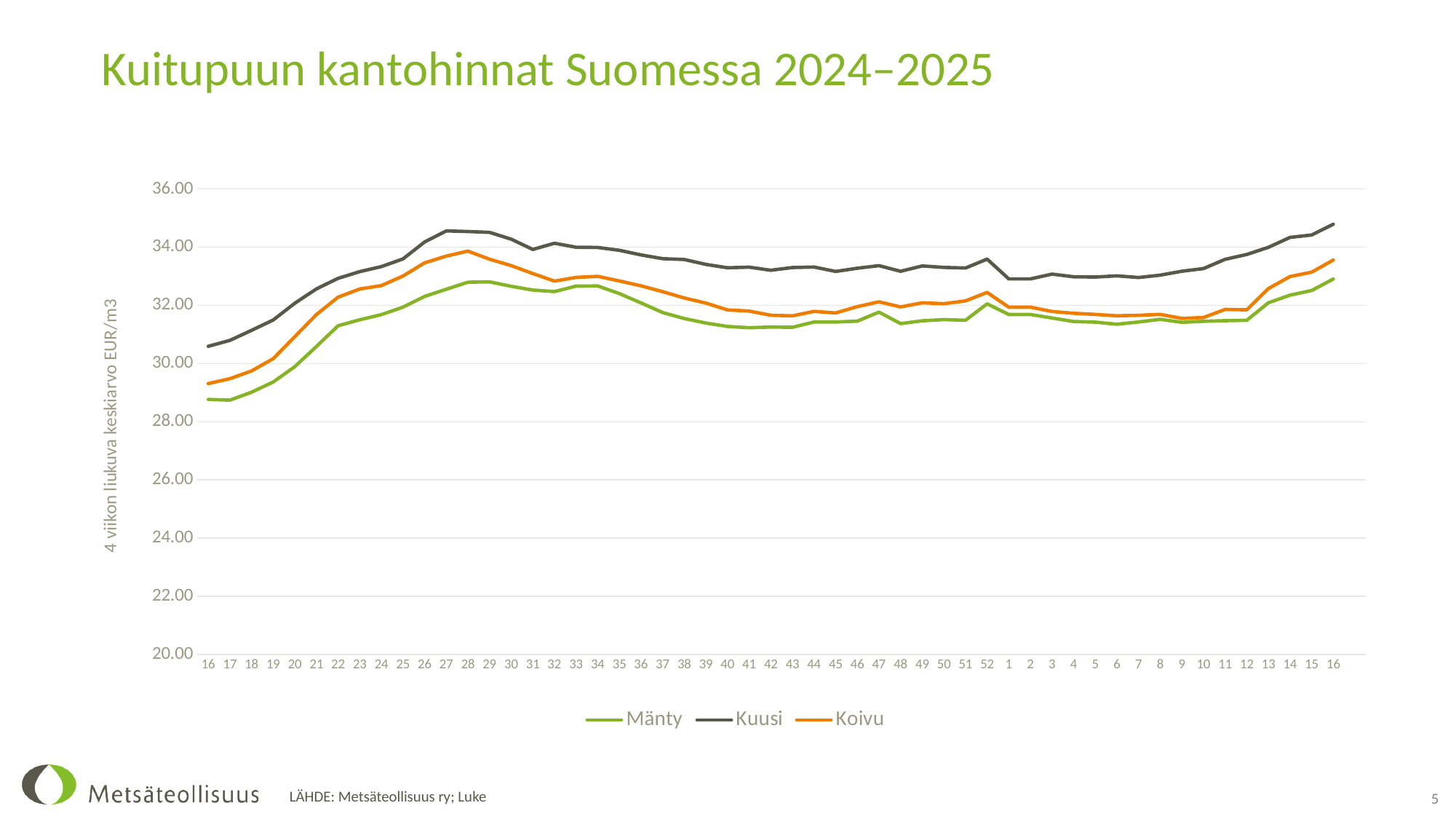
Which series has the lowest values across the whole chart? Mänty Do the Mänty values rise or fall from week 16 to week 28? rise Do the Kuusi values rise or fall from week 28 to week 40? fall Is the value for Mänty at week 40 greater or less than 32.00? less At week 28, which is higher, Koivu or Mänty? Koivu Is the value for Kuusi at week 27 greater or less than 34.00? greater Which series has the highest values across the whole chart? Kuusi Is the value for Mänty at week 16 (the first point) greater or less than 30.00? less What kind of chart is shown on the slide? line chart How many series does the legend list? 3 Which series are listed in the legend? Mänty, Kuusi, Koivu What is the title of the chart? Kuitupuun kantohinnat Suomessa 2024–2025